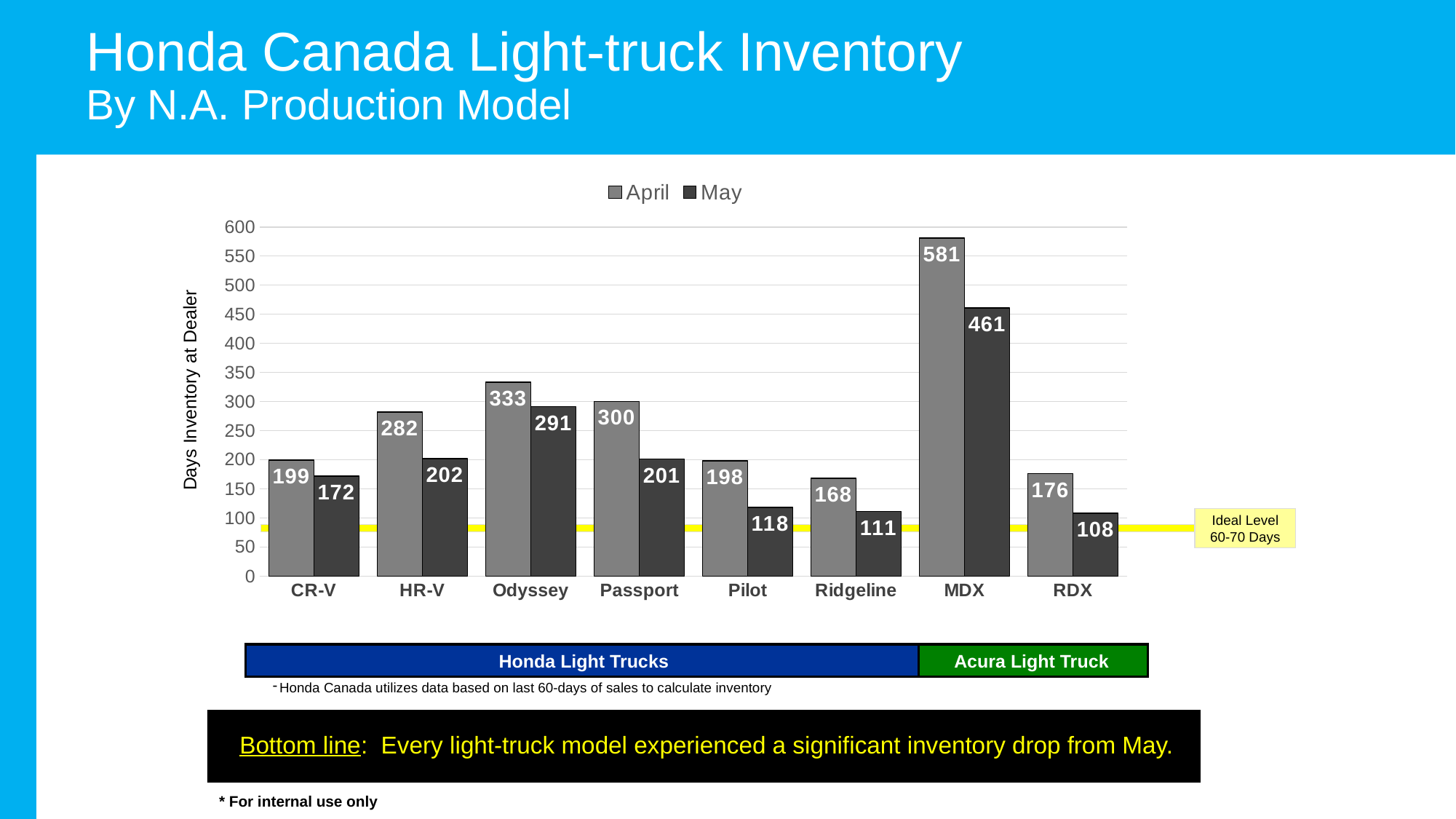
Which model has the highest April days inventory? MDX What is the May days inventory value for the RDX? 108 Which model has the lowest May days inventory? RDX What is the label of the y axis? Days Inventory at Dealer What is the April days inventory value for the Odyssey? 333 Which is larger, the May value for HR-V or the May value for CR-V? HR-V What kind of chart is shown on the slide? Bar chart How many models are shown on the x axis? 8 What is the difference between the April and May values for the Pilot? 80 How many series does the legend list? 2 What is the difference between the April and May values for the MDX? 120 What is the May value for the Passport? 201